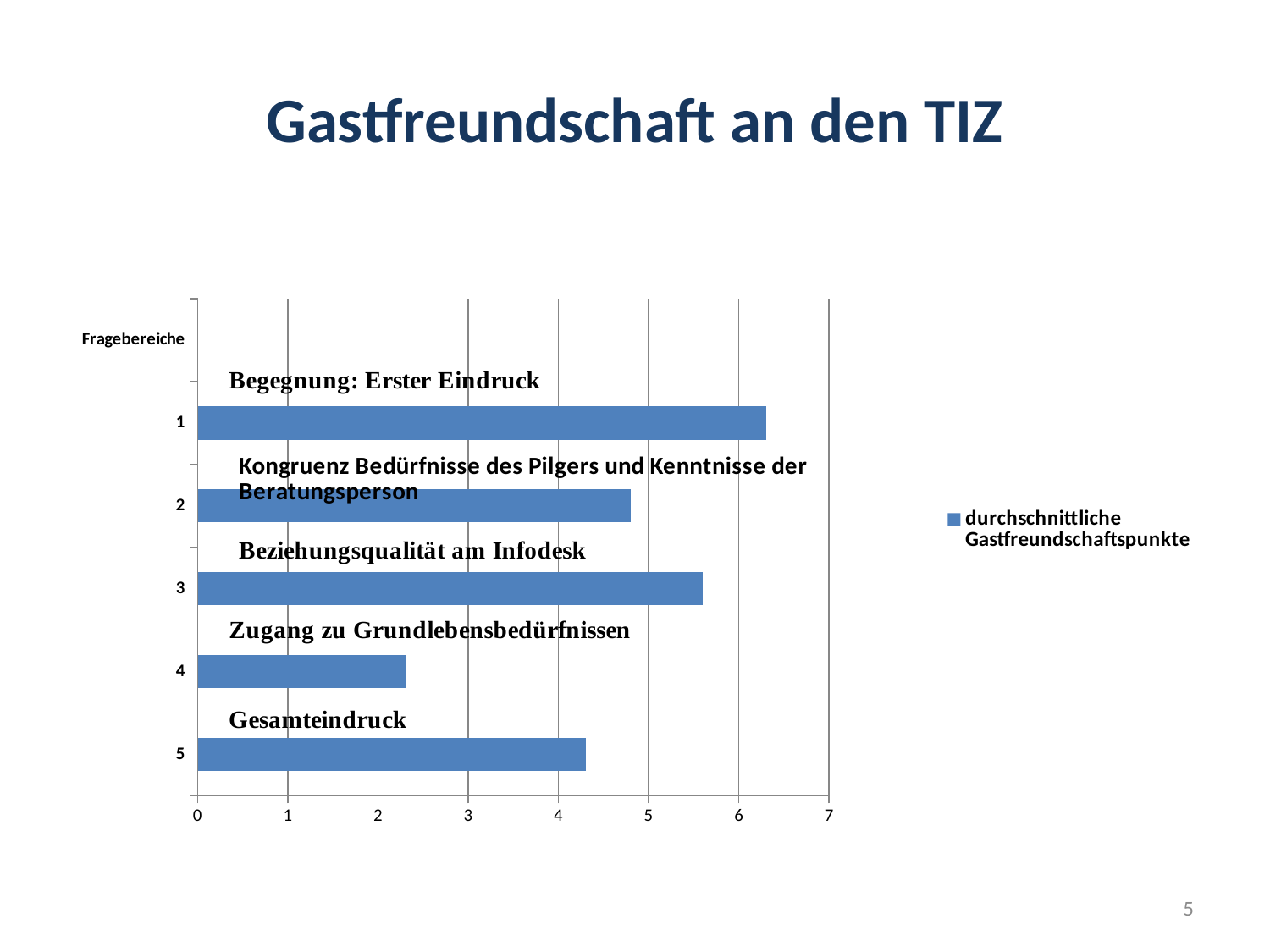
Is the value for Gesamteindruck greater or less than 5? less What kind of chart is shown on the slide? bar chart Is the value for Zugang zu Grundlebensbedürfnissen greater or less than 3? less Which category has the lowest value? Zugang zu Grundlebensbedürfnissen Which category has the highest value? Begegnung: Erster Eindruck Is the value for Beziehungsqualität am Infodesk greater or less than 5? greater How many categories (Fragebereiche) are plotted in the chart? 5 What series name is shown in the chart legend? durchschnittliche Gastfreundschaftspunkte How many series does the legend list? 1 What is the title of the slide containing the chart? Gastfreundschaft an den TIZ Which is larger: the value for Beziehungsqualität am Infodesk or the value for Gesamteindruck? Beziehungsqualität am Infodesk